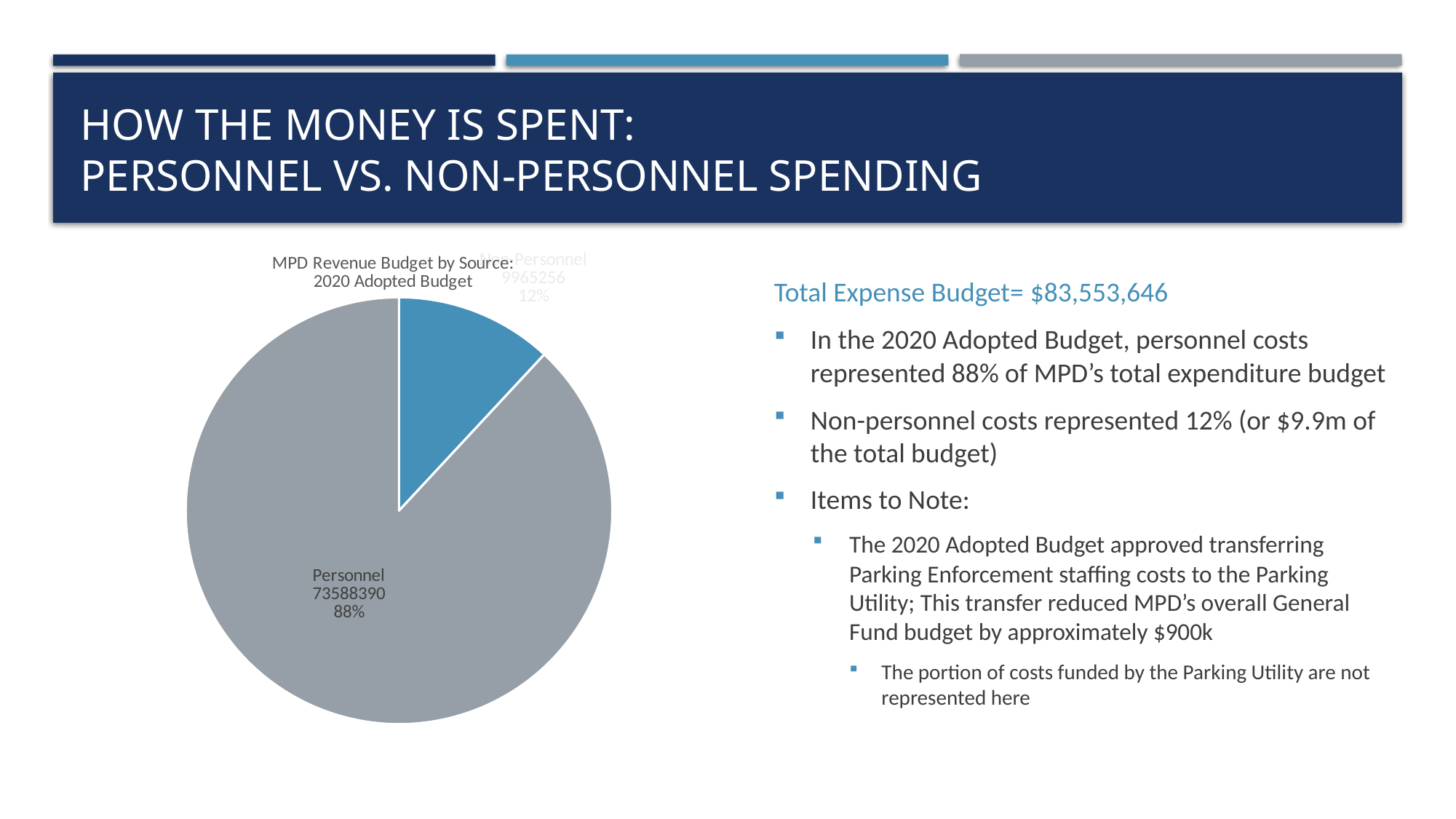
How many slices does the pie chart have? 2 Which is larger, the Personnel slice or the Non-Personnel slice? Personnel What value is shown for the Non-Personnel slice of the pie chart? 9965256 What colour is the Personnel slice of the pie chart? gray What kind of chart is shown on the slide? pie chart What is the title of the pie chart? MPD Revenue Budget by Source: 2020 Adopted Budget Which slice of the pie chart is the smallest? Non-Personnel Which slice of the pie chart is the largest? Personnel What value is shown for the Personnel slice of the pie chart? 73588390 What percentage share does the Non-Personnel slice represent? 12% What is the difference between the Personnel value and the Non-Personnel value in the pie chart? 63623134 What percentage share does the Personnel slice represent? 88%